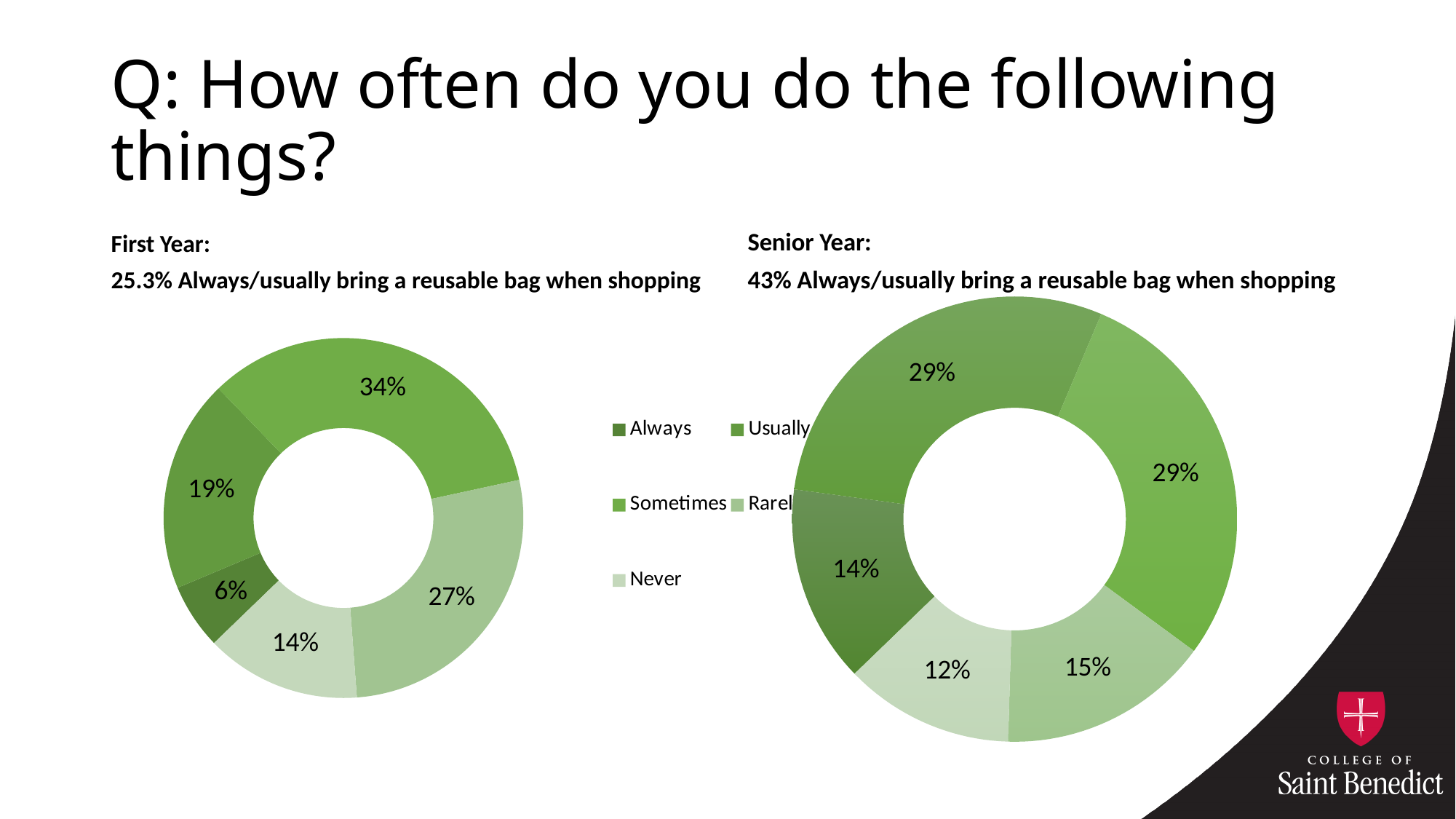
What is the difference between the Always slice in the Senior Year chart (14%) and the Always slice in the First Year chart (6%)? 8 percentage points In the First Year chart, what share is labelled for the Sometimes slice? 34% According to the text above the charts, what percentage of Senior Year students always/usually bring a reusable bag when shopping? 43% In the First Year chart, what is the smallest slice's value? 6% In the First Year chart, what share is labelled for the Always slice? 6% In the First Year chart, what is the largest slice's value? 34% In the Senior Year chart, what share is labelled for the Always slice? 14% How many categories does the legend list? 5 Which chart has the larger Always slice, First Year or Senior Year? Senior Year In the Senior Year chart, what share is labelled for the Never slice? 12% In the Senior Year chart, what is the smallest slice's value? 12% What kind of charts are shown on the slide? Doughnut (pie) charts